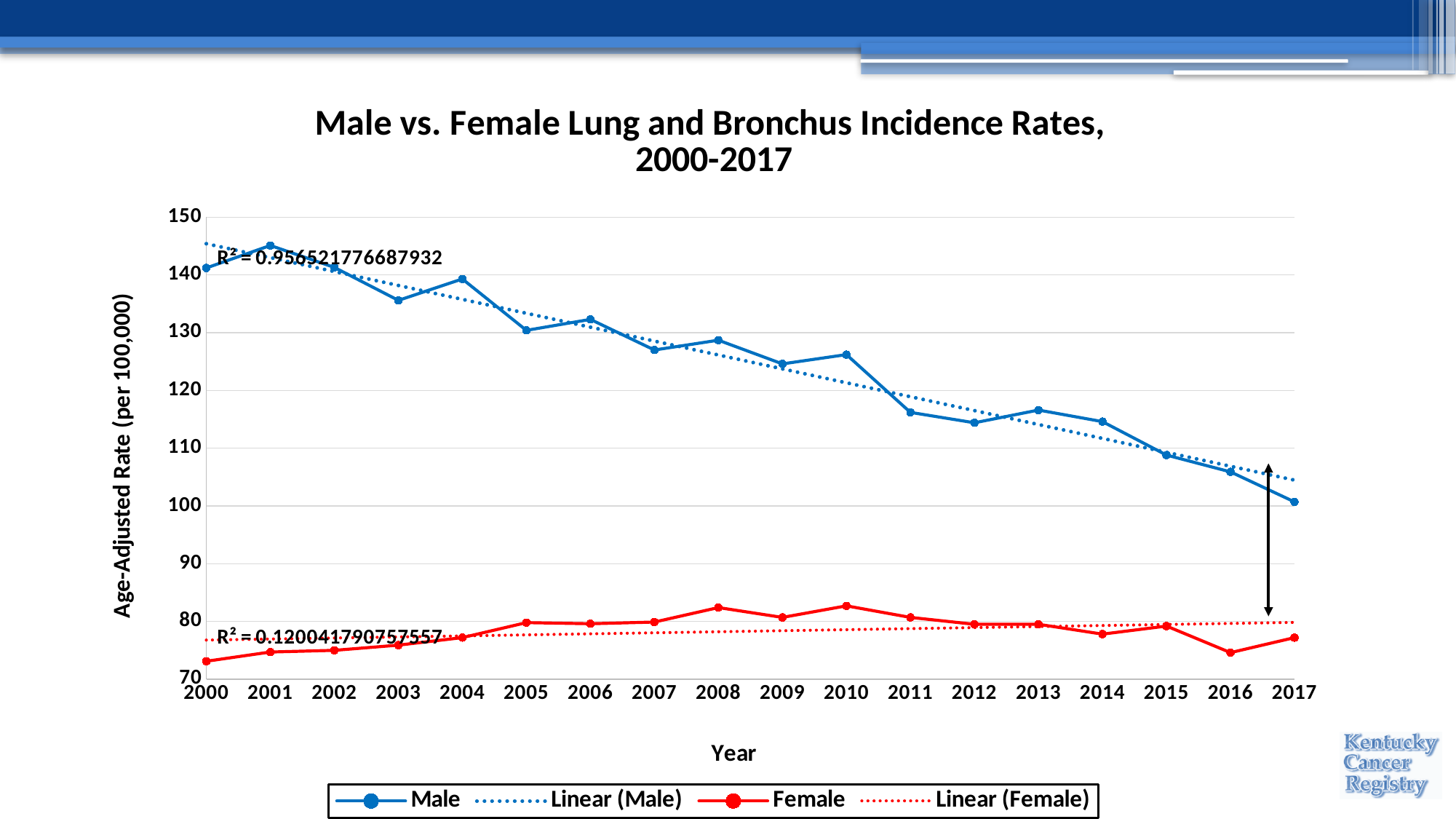
How many years are plotted along the x axis? 18 How many entries does the legend list? 4 What is the R² value shown for the Male trend line? R² = 0.956521776687932 Is the Female value for 2008 greater or less than 80? greater In which year is the Male incidence rate lowest? 2017 What is the label on the y axis? Age-Adjusted Rate (per 100,000) Is the Female value for 2000 greater or less than 80? less In 2010, which series has the larger value, Male or Female? Male Is the Male value for 2017 greater or less than 110? less Does the Male incidence rate rise or fall from 2000 to 2017? Fall In which year is the Male incidence rate highest? 2001 What kind of chart is shown on the slide? Line chart